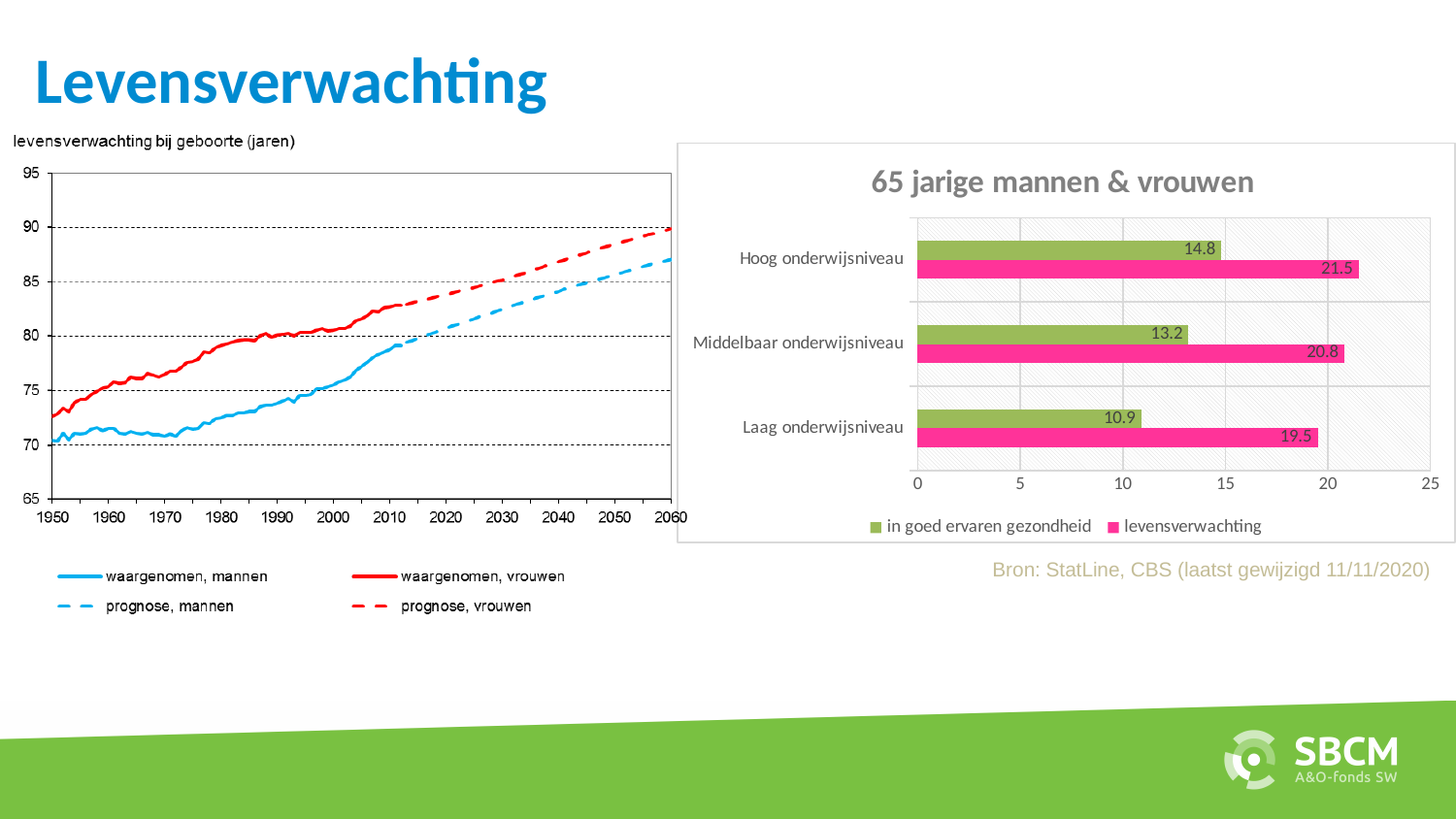
In the chart on the left titled 'levensverwachting bij geboorte (jaren)', is the value for 'waargenomen, mannen' in 1950 greater or less than 75? less In the chart titled '65 jarige mannen & vrouwen', what is the value of 'in goed ervaren gezondheid' for 'Laag onderwijsniveau'? 10.9 In the chart titled '65 jarige mannen & vrouwen', which education level has the highest 'levensverwachting' value? Hoog onderwijsniveau What kind of chart is the chart on the left of the slide, titled 'levensverwachting bij geboorte (jaren)'? line chart In the chart titled '65 jarige mannen & vrouwen', what is the difference in 'levensverwachting' between 'Hoog onderwijsniveau' and 'Middelbaar onderwijsniveau'? 0.7 In the chart on the left titled 'levensverwachting bij geboorte (jaren)', do the values for 'prognose, vrouwen' rise or fall from 2020 to 2060? rise In the chart titled '65 jarige mannen & vrouwen', which education level has the lowest 'in goed ervaren gezondheid' value? Laag onderwijsniveau In the chart titled '65 jarige mannen & vrouwen', how many education-level categories are shown? 3 In the chart titled '65 jarige mannen & vrouwen', what is the value of 'in goed ervaren gezondheid' for 'Middelbaar onderwijsniveau'? 13.2 In the chart titled '65 jarige mannen & vrouwen', what is the difference between 'levensverwachting' and 'in goed ervaren gezondheid' for 'Laag onderwijsniveau'? 8.6 In the chart titled '65 jarige mannen & vrouwen', how many series does the legend list? 2 In the chart titled '65 jarige mannen & vrouwen', what is the value of 'levensverwachting' for 'Hoog onderwijsniveau'? 21.5